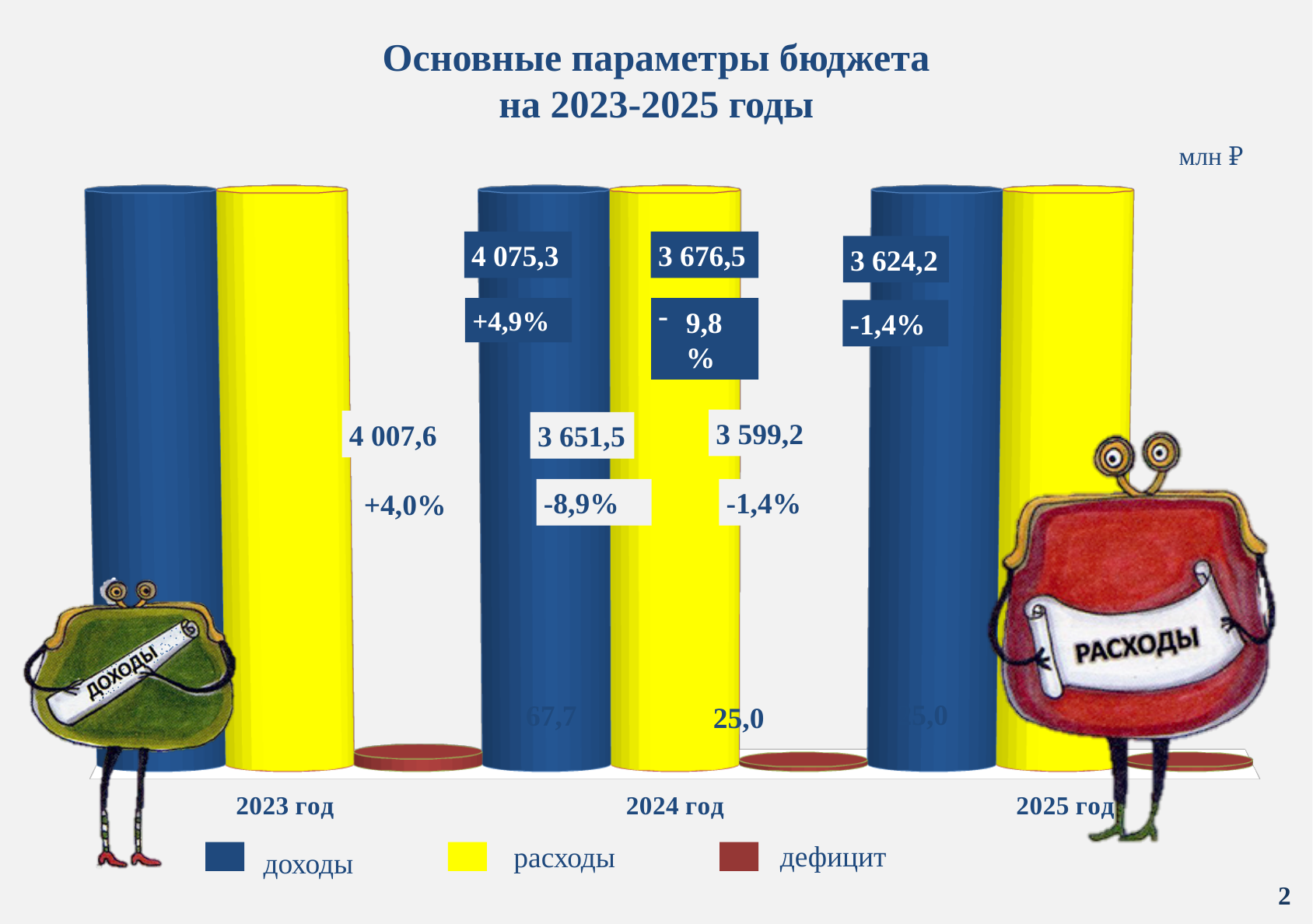
What is the smallest of the large budget values labelled on the chart (excluding the deficit labels)? 3 599,2 What is the difference between the values 4 075,3 and 4 007,6? 67,7 What is the title of the chart? Основные параметры бюджета на 2023-2025 годы In what units are the values on the chart given? млн ₽ Which year label appears leftmost on the x axis? 2023 год How many series does the legend list? 3 How many years (categories) are shown along the x axis? 3 What is the largest value labelled on the chart? 4 075,3 Which is larger, the value 3 651,5 or the value 3 599,2? 3 651,5 Which percentage change label on the chart shows the largest increase? +4,9% What kind of chart is shown on the slide? bar chart Which percentage change label on the chart shows the largest decrease? -9,8%